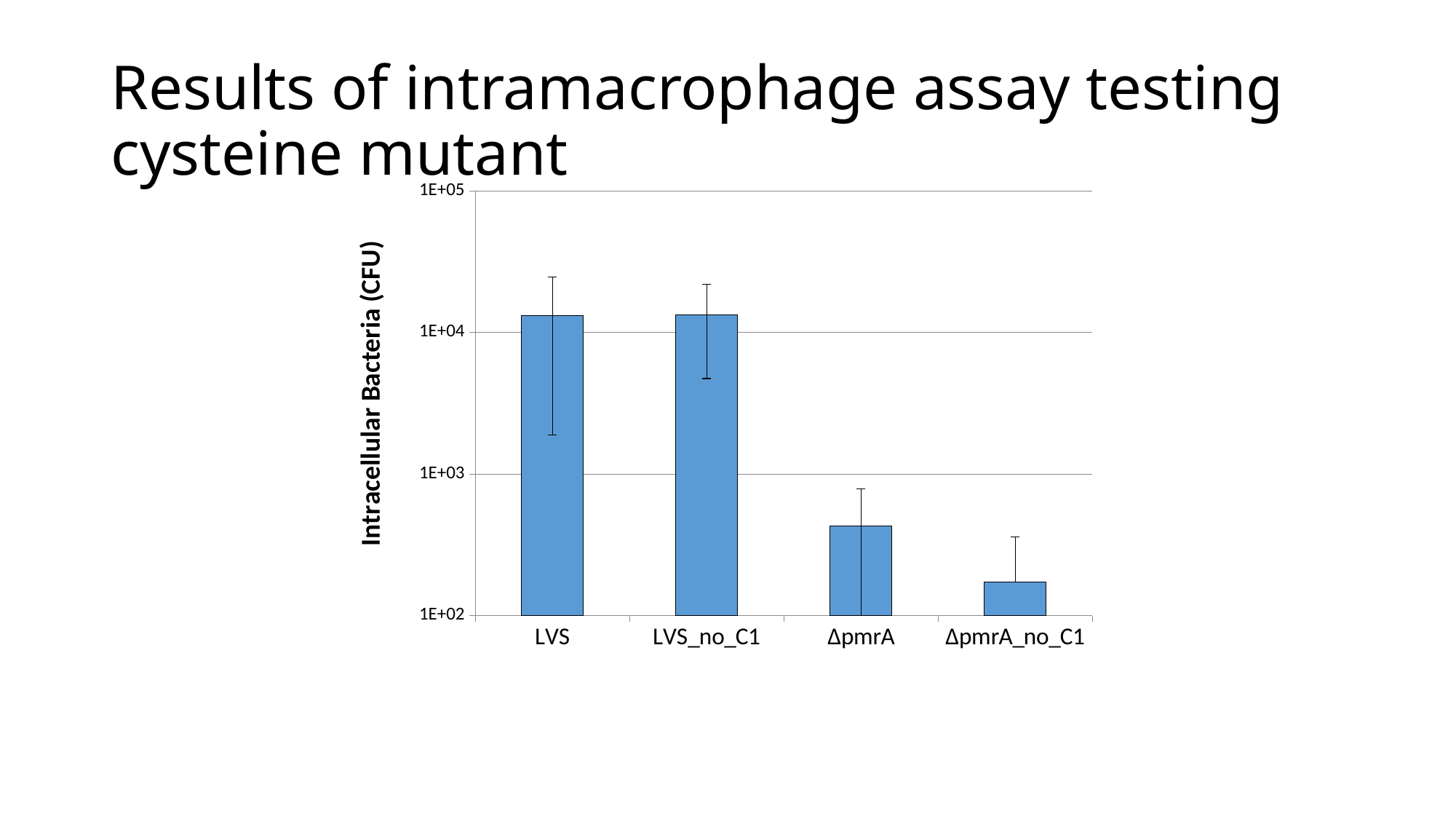
Which category has the lowest intracellular bacteria value? ΔpmrA_no_C1 How many categories are plotted on the x axis? 4 What kind of chart is shown on the slide? bar chart Is the value for LVS_no_C1 greater or less than 1E+04? greater Which is larger, the value for ΔpmrA or the value for ΔpmrA_no_C1? ΔpmrA What is the label of the y axis? Intracellular Bacteria (CFU) Do the bar values generally rise or fall from left to right along the x axis? fall Is the value for ΔpmrA greater or less than 1E+03? less Is the value for LVS greater or less than 1E+04? greater Which is larger, the value for LVS or the value for ΔpmrA? LVS